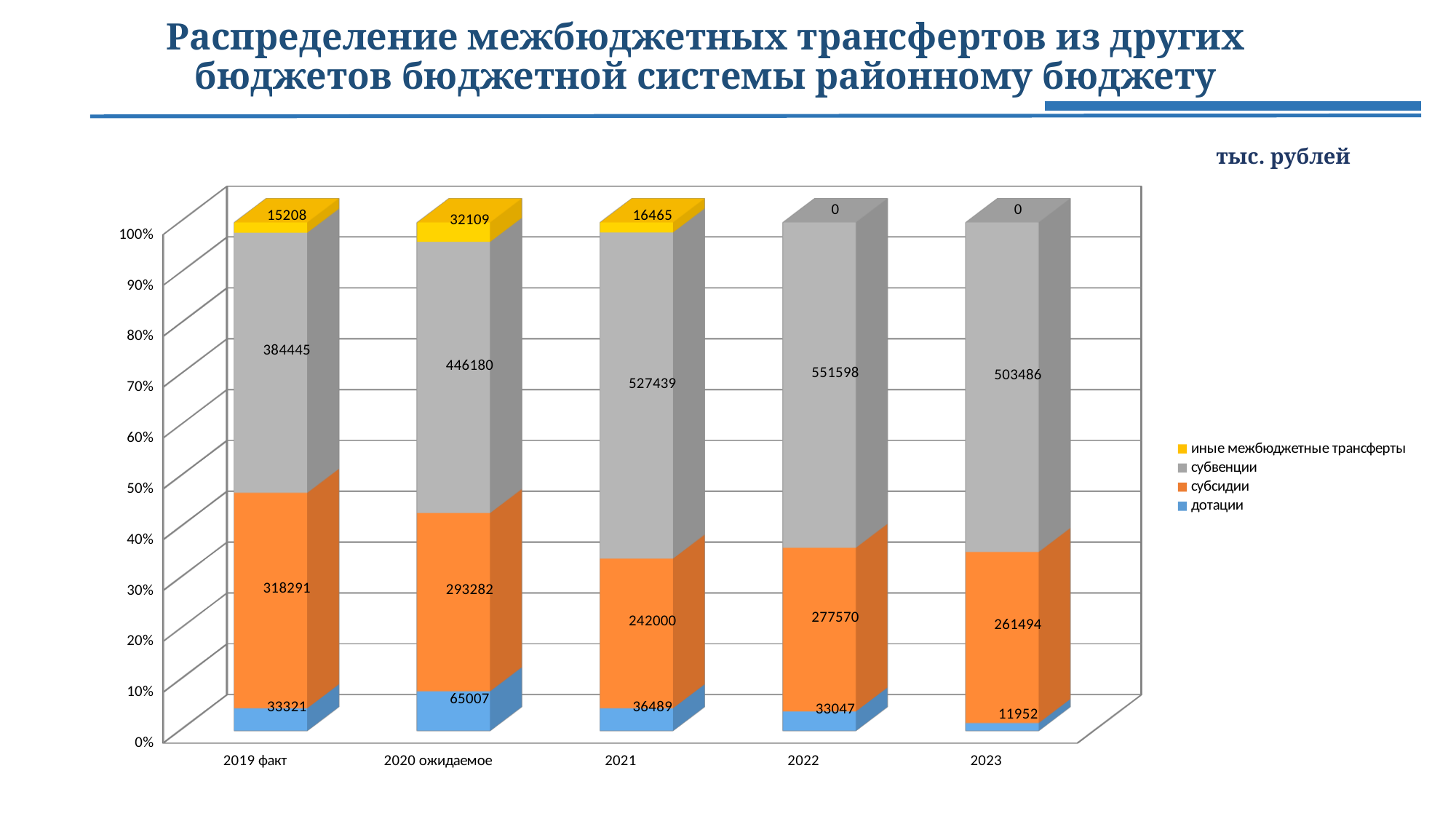
How many categories (years) are shown on the x axis? 5 What is the difference between субсидии in 2019 факт and субсидии in 2021? 76291 Which is larger: иные межбюджетные трансферты in 2020 ожидаемое or in 2021? 2020 ожидаемое In which year is the value of дотации the lowest? 2023 What is the total of all four series for 2022? 862215 What is the value of субвенции for 2021? 527439 What kind of chart is shown on the slide? Stacked bar chart In which year is the value of субвенции the highest? 2022 What is the value of иные межбюджетные трансферты for 2022? 0 How many series does the legend list? 4 What is the value of субсидии for 2023? 261494 What is the value of дотации for 2020 ожидаемое? 65007